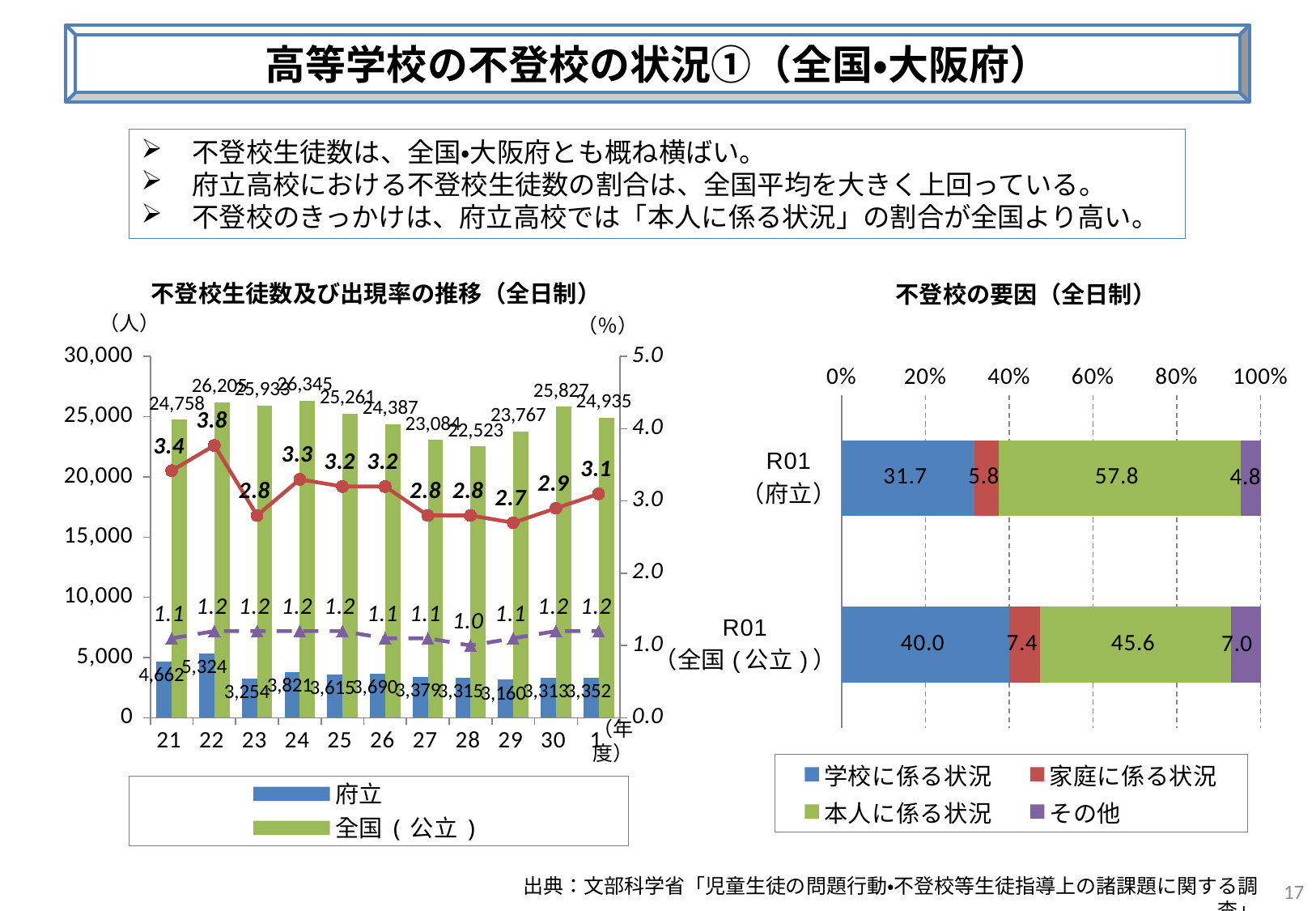
In the left chart (不登校生徒数及び出現率の推移), which year has the highest 全国（公立） value? 24 In the left chart (不登校生徒数及び出現率の推移), what is the difference between the 全国（公立） values for year 22 and year 28? 3,682 In the right chart (不登校の要因), how many series does the legend list? 4 In the left chart (不登校生徒数及び出現率の推移), how many years are shown on the x axis? 11 In the right chart (不登校の要因), what is the 学校に係る状況 value for R01（全国（公立））? 40.0 In the right chart (不登校の要因), what is the 本人に係る状況 value for R01（府立）? 57.8 In the left chart (不登校生徒数及び出現率の推移), which year has the lowest 全国（公立） value? 28 In the left chart (不登校生徒数及び出現率の推移), what value does the red solid line show for year 22? 3.8 In the left chart (不登校生徒数及び出現率の推移), which year has the highest 府立 value? 22 In the right chart (不登校の要因), which has the larger 本人に係る状況 value, R01（府立） or R01（全国（公立））? R01（府立） In the left chart (不登校生徒数及び出現率の推移), what is the 全国（公立） value for year 24? 26,345 In the left chart (不登校生徒数及び出現率の推移), what is the 府立 value for year 22? 5,324